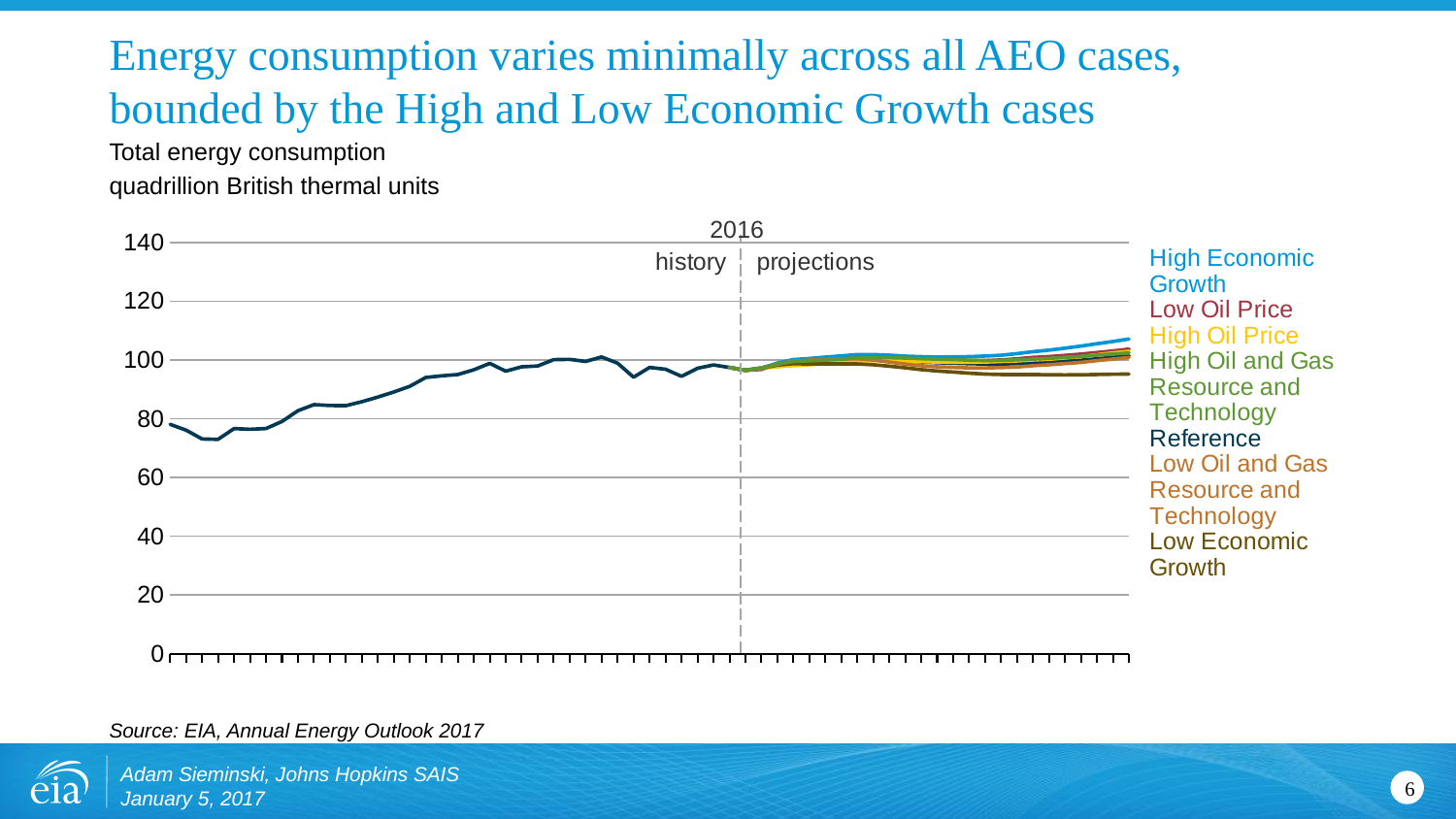
Is the lowest value in the history portion of the chart greater or less than 80? less Which year marks the boundary between history and projections on the chart? 2016 How many series does the legend list? 7 Does total energy consumption generally rise or fall over the history portion of the chart? rise Is the value for High Economic Growth at the end of the projection period greater or less than 100? greater What unit is total energy consumption measured in on the chart? quadrillion British thermal units What kind of chart is shown on the slide? line chart Is the value for Low Economic Growth at the end of the projection period greater or less than 100? less Which case has the lowest total energy consumption at the end of the projection period? Low Economic Growth Which case has the highest total energy consumption at the end of the projection period? High Economic Growth At the end of the projection period, which is larger: the High Economic Growth case or the Low Economic Growth case? High Economic Growth